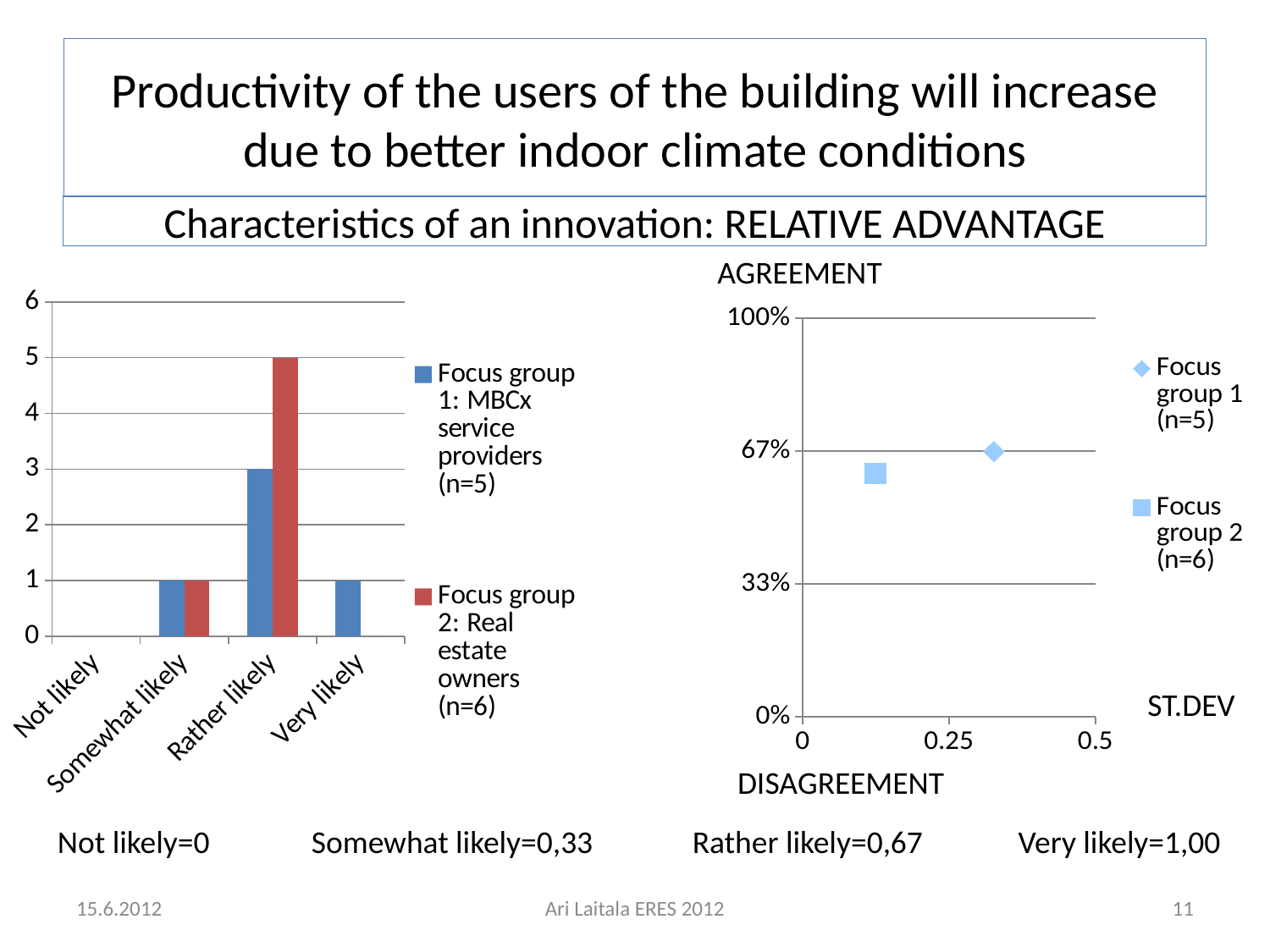
What kind of chart is the chart on the left of the slide? bar chart In the bar chart on the left, which category has the highest value for Focus group 1: MBCx service providers (n=5)? Rather likely In the bar chart on the left, which series has the larger value at Very likely? Focus group 1: MBCx service providers (n=5) In the bar chart on the left, what is the value for Focus group 2: Real estate owners (n=6) at Rather likely? 5 How many categories are shown on the x axis of the bar chart on the left? 4 In the scatter chart on the right, which focus group has the higher AGREEMENT value? Focus group 1 (n=5) How many series does the legend of the bar chart on the left list? 2 In the bar chart on the left, what is the difference between Focus group 2 and Focus group 1 at Rather likely? 2 In the scatter chart on the right, what is the AGREEMENT value for Focus group 1 (n=5)? 67% What kind of chart is the chart on the right of the slide? scatter chart In the scatter chart on the right, is the ST.DEV value for Focus group 2 (n=6) greater or less than 0.25? less In the bar chart on the left, what is the value for Focus group 1: MBCx service providers (n=5) at Rather likely? 3